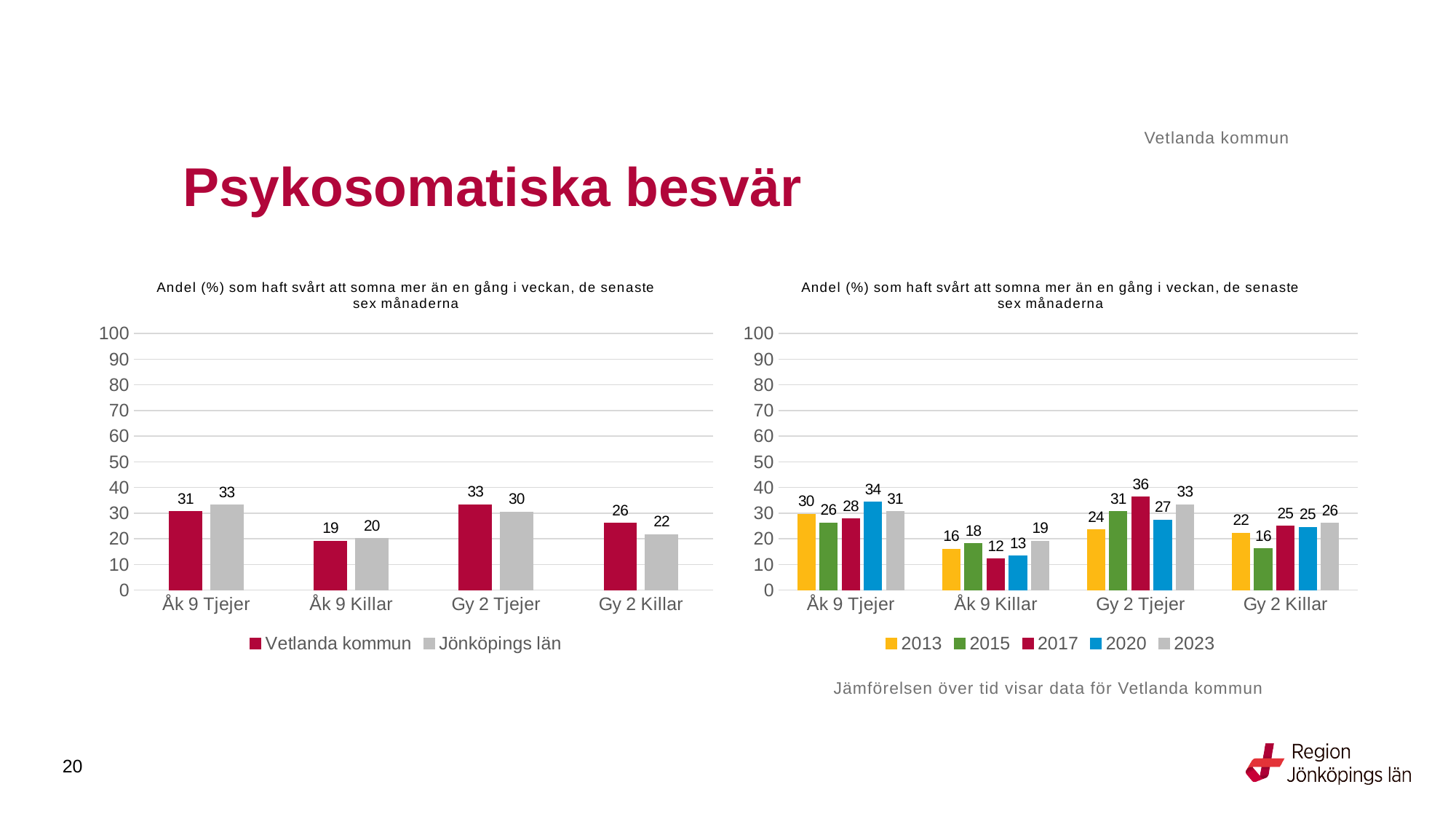
In the left chart, which category has the lowest value for Vetlanda kommun? Åk 9 Killar In the right chart, what is the value for 2017 for Åk 9 Killar? 12 In the left chart, what is the difference between Vetlanda kommun and Jönköpings län for Gy 2 Killar? 4 In the right chart, which is larger for Gy 2 Killar: the value for 2013 or the value for 2015? 2013 In the right chart, how many series does the legend list? 5 In the left chart, what is the value for Vetlanda kommun for Åk 9 Tjejer? 31 In the left chart, how many series does the legend list? 2 In the right chart, what is the difference between the 2023 and 2013 values for Åk 9 Killar? 3 What kind of chart is the right chart? Bar chart In the right chart, which year has the highest value for Gy 2 Tjejer? 2017 In the right chart, what is the value for 2020 for Åk 9 Tjejer? 34 In the left chart, what is the value for Jönköpings län for Gy 2 Killar? 22